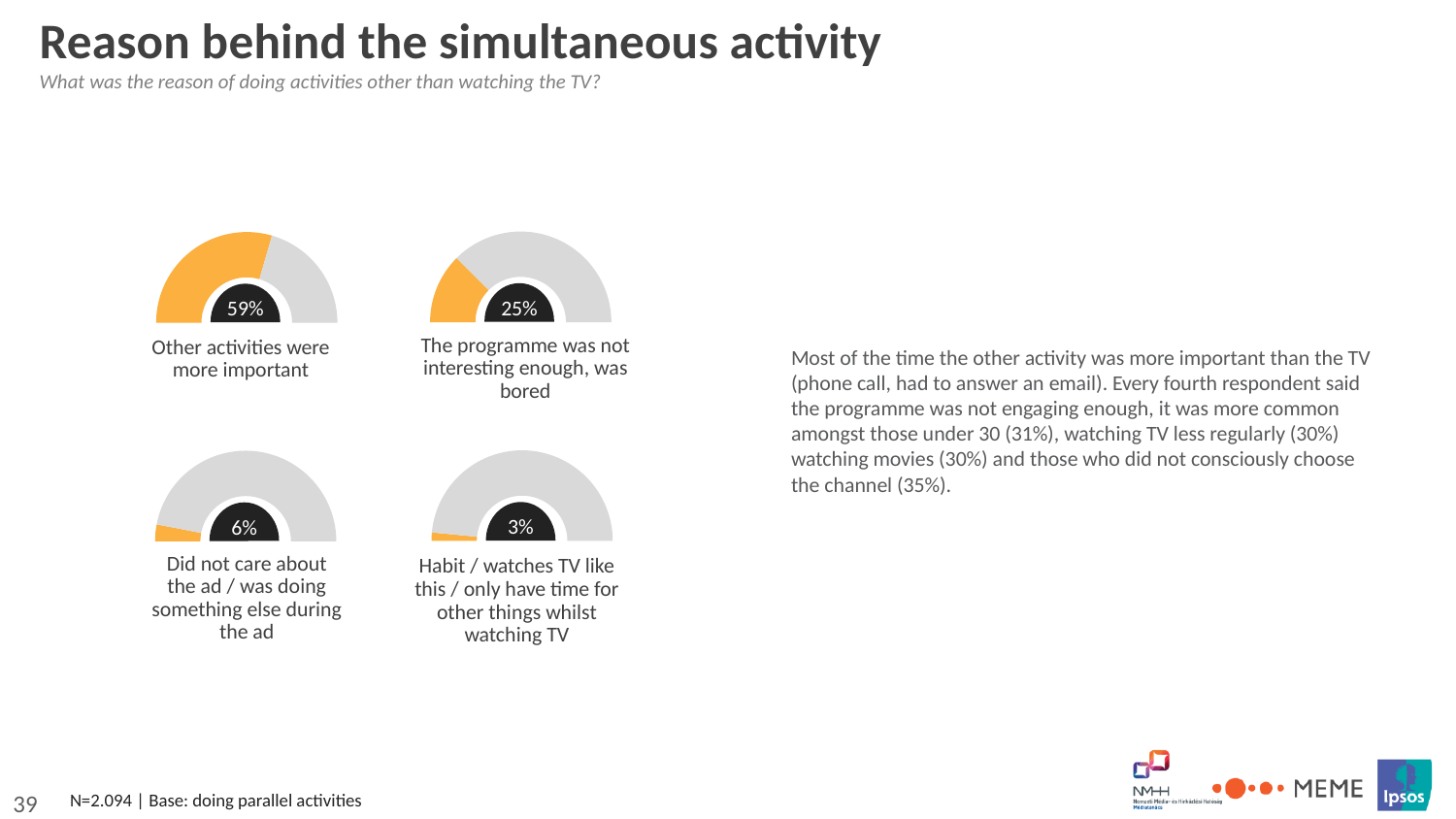
Which reason has the lowest share of respondents? Habit / watches TV like this / only have time for other things whilst watching TV What percentage of respondents said other activities were more important? 59% What colour is used for the filled portion of each gauge? Orange What kind of charts are used to display the reasons on the slide? Gauge (semi-circular donut) charts Which is larger: the share for 'The programme was not interesting enough' or the share for 'Did not care about the ad'? The programme was not interesting enough What percentage of respondents said the programme was not interesting enough / they were bored? 25% What percentage of respondents gave habit / only having time for other things whilst watching TV as the reason? 3% What is the difference in percentage points between 'Other activities were more important' and 'The programme was not interesting enough, was bored'? 34 percentage points What is the difference in percentage points between 'Did not care about the ad' and 'Habit / watches TV like this'? 3 percentage points How many reasons are shown as gauge charts on the slide? 4 Which reason has the highest share of respondents? Other activities were more important What percentage of respondents said they did not care about the ad / were doing something else during the ad? 6%